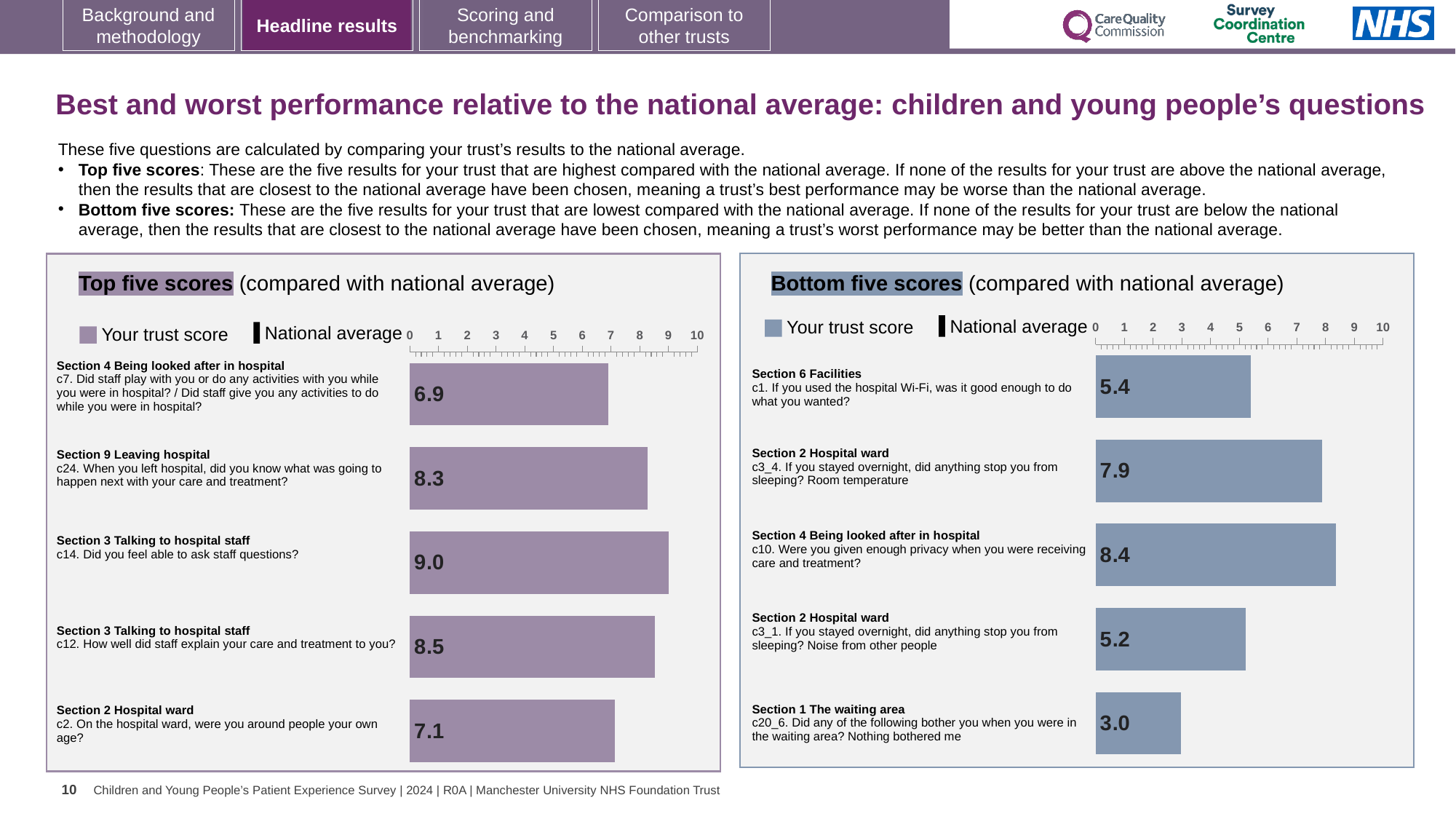
In the Bottom five scores chart, which has the larger trust score: c1 (hospital Wi-Fi) or c3_1 (noise from other people)? c1 (hospital Wi-Fi) In the Top five scores chart, which question has the highest trust score? c14. Did you feel able to ask staff questions? How many bars are shown in the Bottom five scores chart? 5 In the Top five scores chart, what is the trust score for c14 'Did you feel able to ask staff questions?' 9.0 In the Bottom five scores chart, what is the trust score for c20_6 'Nothing bothered me' in the waiting area? 3.0 In the Top five scores chart, what is the difference between the trust scores for c12 and c24? 0.2 In the Top five scores chart, which question has the lowest trust score? c7. Did staff play with you or do any activities with you while you were in hospital? In the Bottom five scores chart, what is the trust score for c3_4 'Room temperature'? 7.9 In the Top five scores chart, what is the trust score for c2 'On the hospital ward, were you around people your own age?' 7.1 What type of chart is used for the Top five scores? Bar chart In the Bottom five scores chart, which question has the lowest trust score? c20_6. Nothing bothered me (waiting area) In the Bottom five scores chart, which question has the highest trust score? c10. Were you given enough privacy when you were receiving care and treatment?